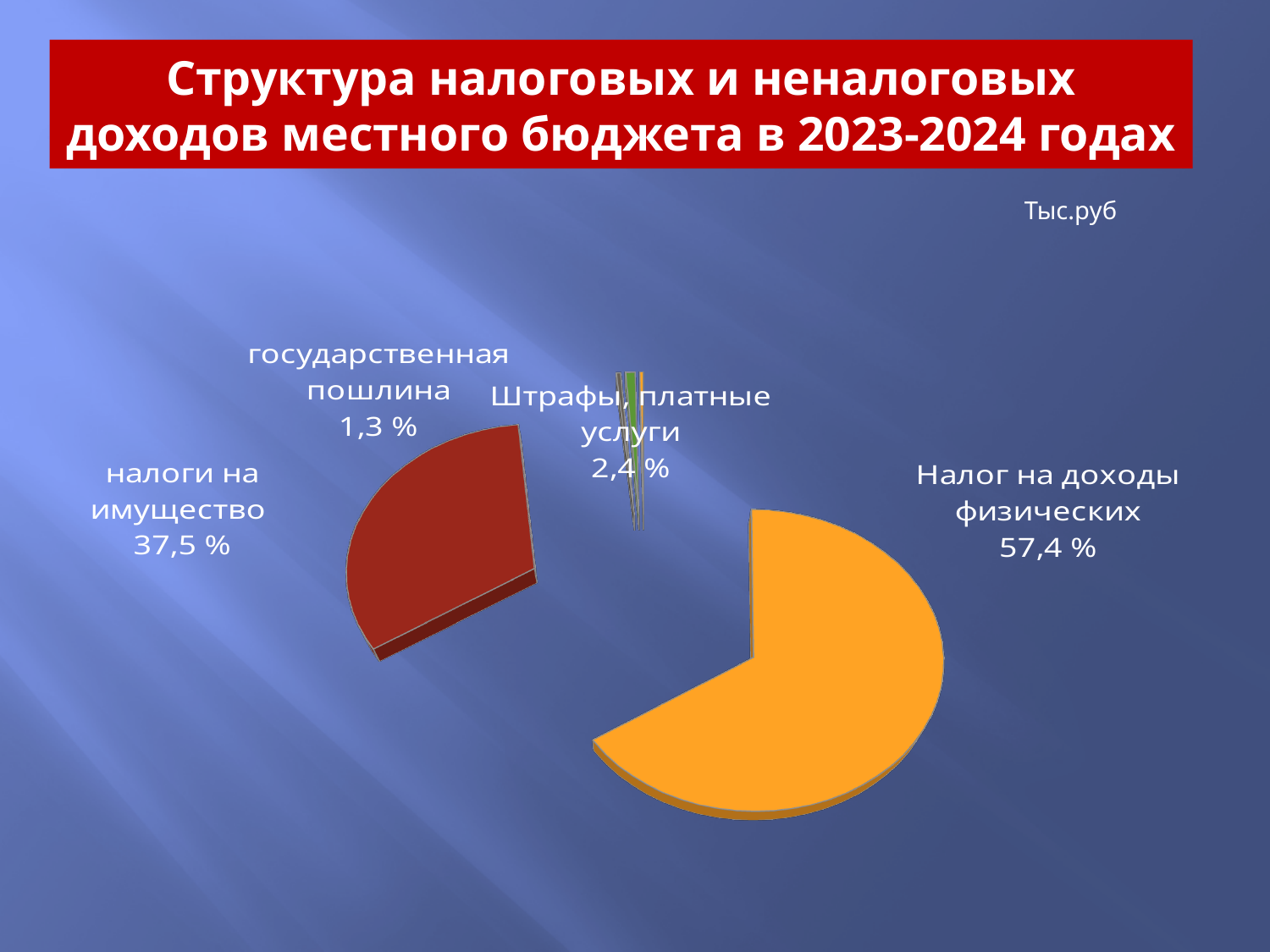
Which is larger: "налоги на имущество" or "Налог на доходы физических"? Налог на доходы физических What is the difference in percentage points between "Налог на доходы физических" and "налоги на имущество"? 19,9 Which slice of the pie is the smallest? государственная пошлина Which slice of the pie is the largest? Налог на доходы физических What share of the pie does "государственная пошлина" have? 1,3 % What share of the pie does "налоги на имущество" have? 37,5 % What is the difference in percentage points between "Штрафы, платные услуги" and "государственная пошлина"? 1,1 What share of the pie does "Налог на доходы физических" have? 57,4 % What kind of chart is shown on the slide? Pie chart What share of the pie does "Штрафы, платные услуги" have? 2,4 % What is the title of the chart on the slide? Структура налоговых и неналоговых доходов местного бюджета в 2023-2024 годах